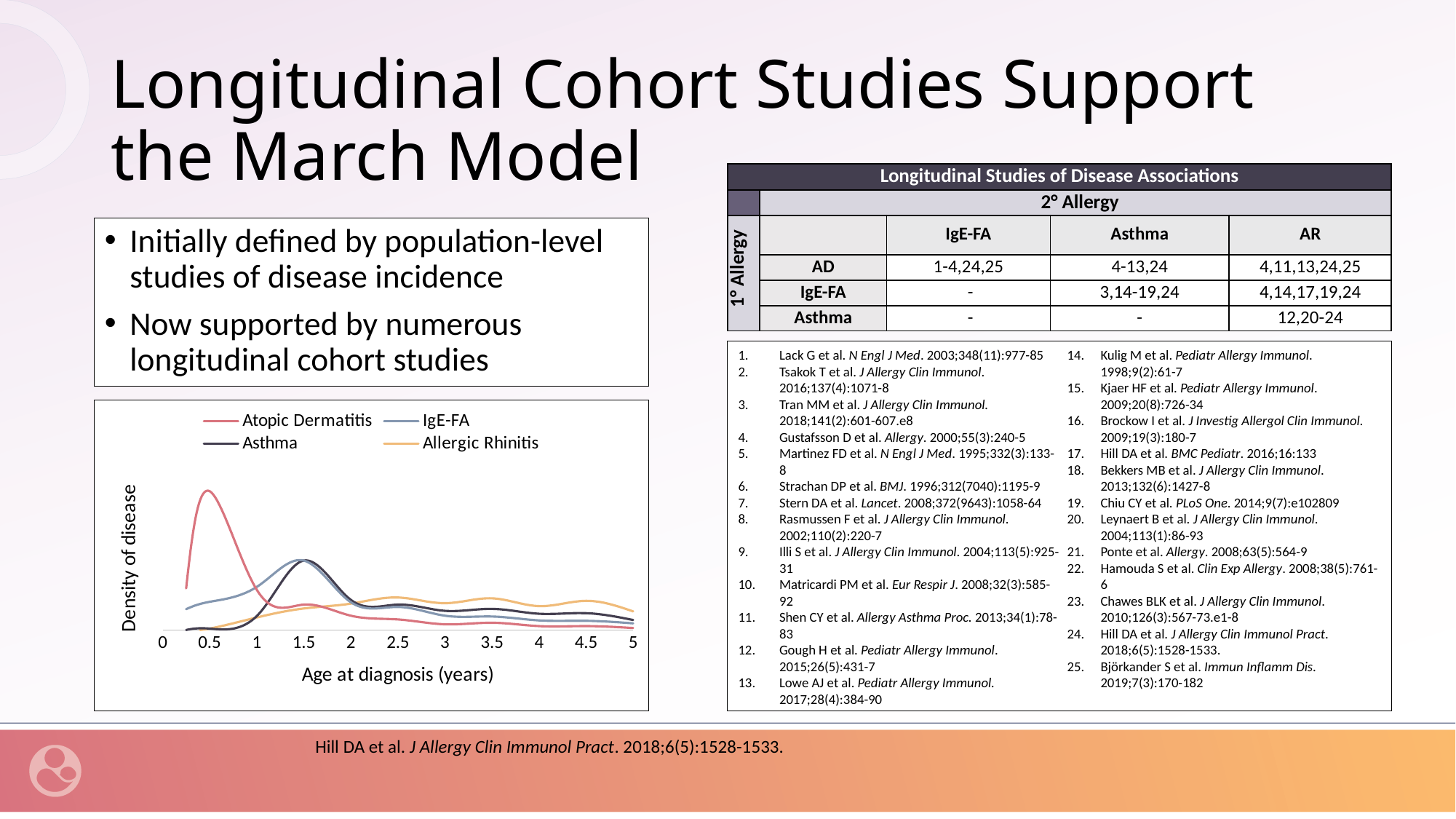
Which series has the lowest density at age 5 years? Atopic Dermatitis Which series has the highest density at age 4.5 years? Allergic Rhinitis Does the Asthma curve rise or fall between ages 1 and 1.5 years? Rise What kind of chart is shown on the slide? Line chart Which series has a higher peak: Asthma or Allergic Rhinitis? Asthma Which series in the chart reaches the highest peak density of disease? Atopic Dermatitis How many tick labels are shown on the chart's x axis? 11 What is the label of the chart's x axis? Age at diagnosis (years) Which series peaks at the earliest age at diagnosis? Atopic Dermatitis What is the label of the chart's y axis? Density of disease Does the Atopic Dermatitis curve rise or fall between ages 0.5 and 2 years? Fall How many series does the chart's legend list? 4